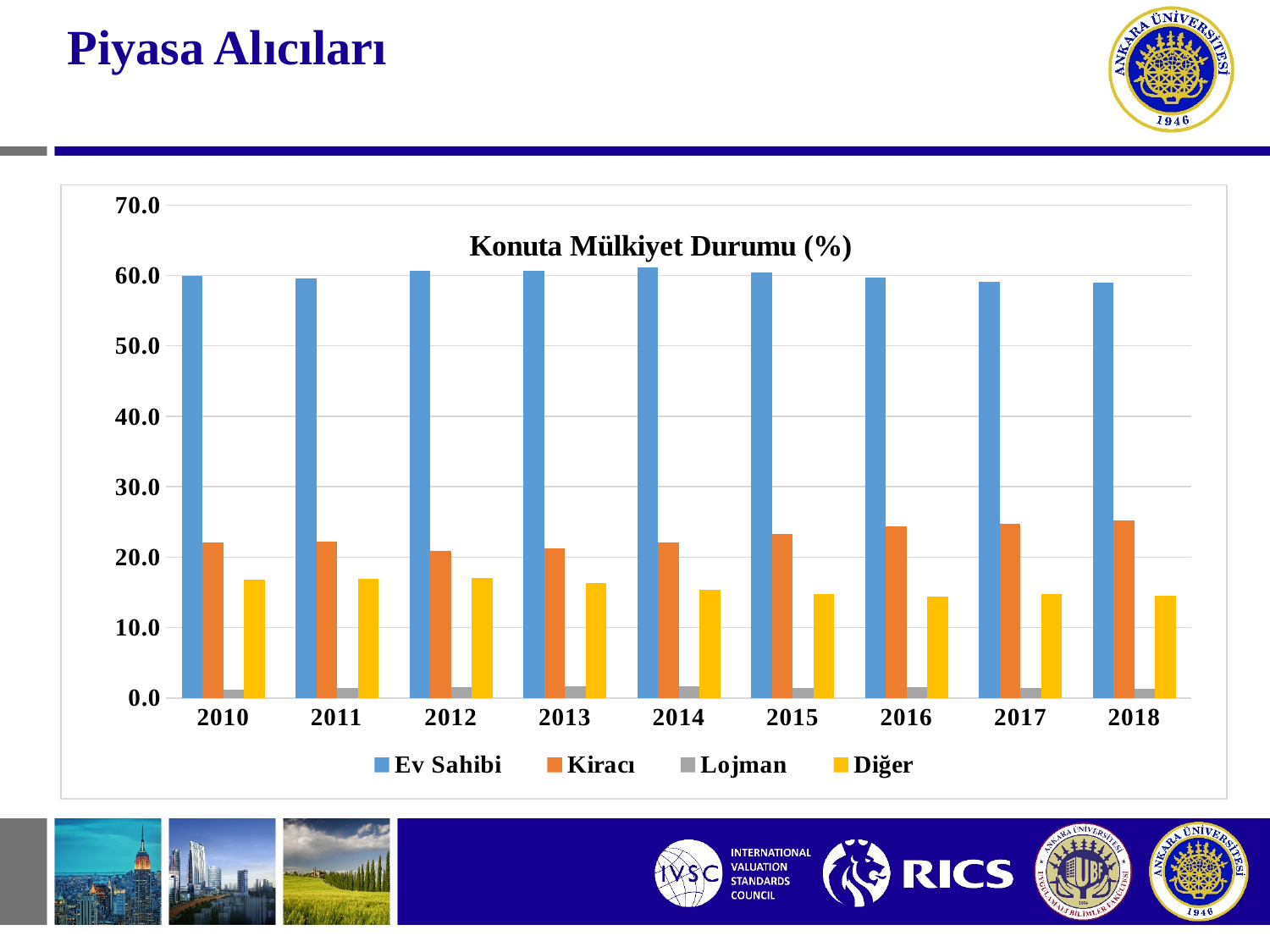
Which series has the highest value in 2014? Ev Sahibi How many years are shown on the x axis? 9 What is the title of the chart? Konuta Mülkiyet Durumu (%) Do the values for Kiracı rise or fall from 2014 to 2018? Rise Which is larger in 2018, Kiracı or Diğer? Kiracı Is the value for Diğer in 2016 greater or less than 20.0? less Is the value for Lojman in 2013 greater or less than 10.0? less How many series does the legend list? 4 What kind of chart is shown on the slide? Bar chart Is the value for Kiracı in 2018 greater or less than 20.0? greater Which series has the lowest value in 2010? Lojman